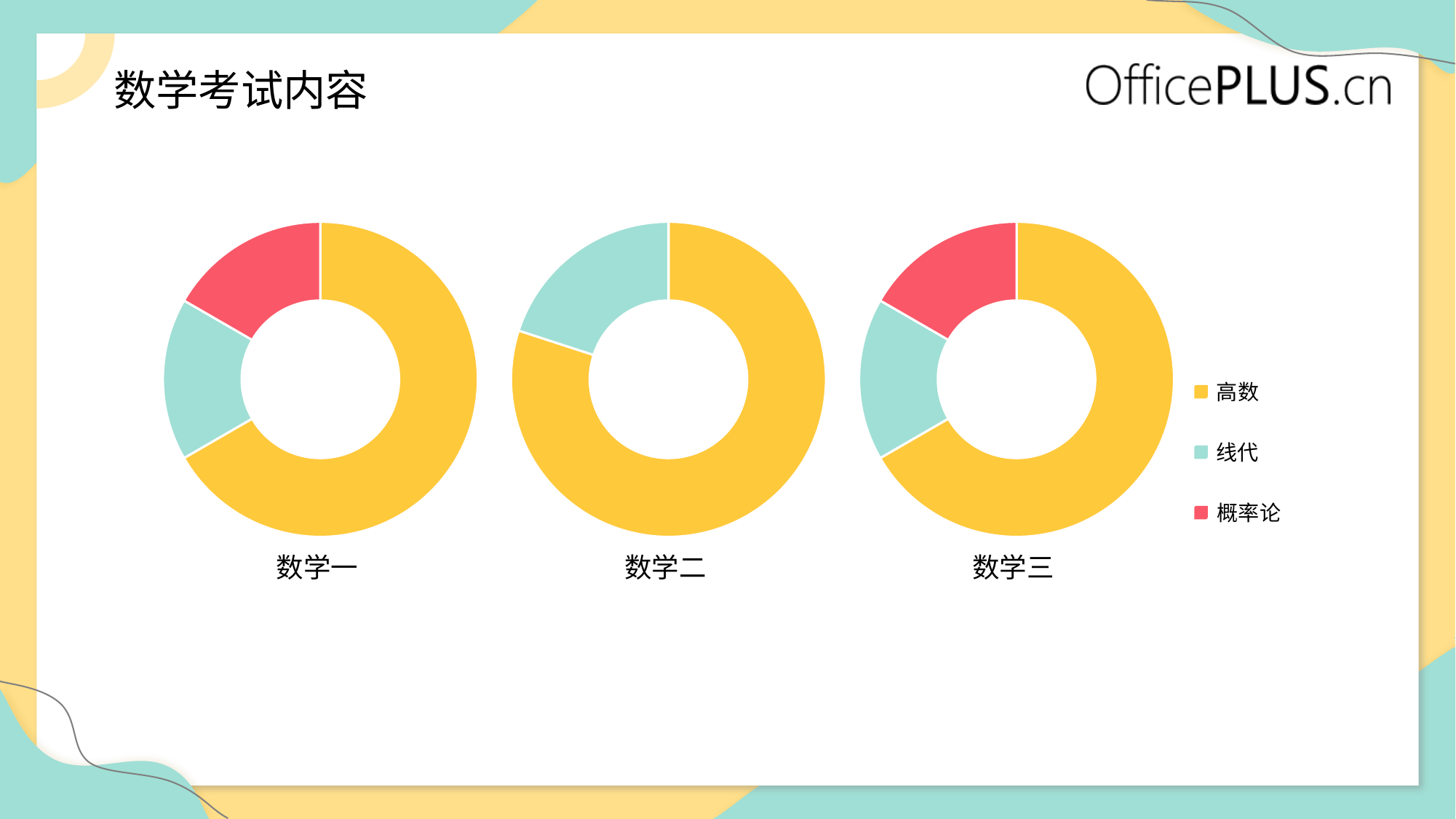
How many categories does the legend list? 3 How many slices are visible in the 数学二 chart? 2 How many charts are shown on the slide? 3 In the 数学一 chart, which is larger, 高数 or 概率论? 高数 What is the title of the slide? 数学考试内容 Which colour represents 概率论 in the legend? red In the 数学二 chart, which is larger, 高数 or 线代? 高数 In the 数学三 chart, which category has the largest share? 高数 What kind of chart is used for 数学一, 数学二 and 数学三? donut (pie) chart In the 数学二 chart, which category has the largest share? 高数 In the 数学二 chart, which legend category has no visible slice? 概率论 In the 数学一 chart, which category has the largest share? 高数